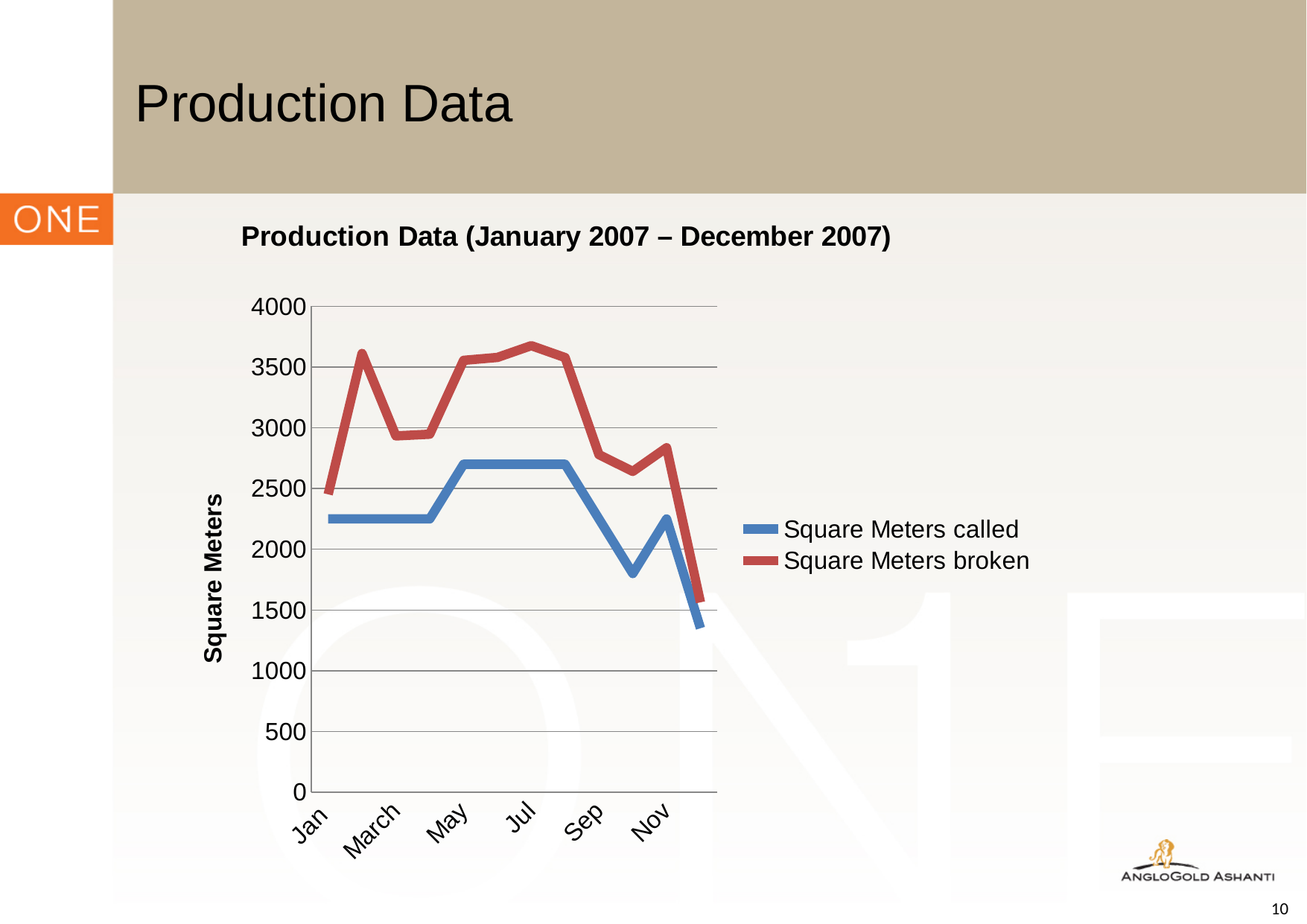
Is the value for Square Meters broken in Jul greater or less than 3500? greater In which month is Square Meters called at its lowest? Dec Is the value for Square Meters broken in March greater or less than 3500? less Is the value for Square Meters called in Jul greater or less than 2500? greater What is the label of the vertical axis? Square Meters How many month labels are shown on the x axis? 6 How many series does the legend list? 2 Do the values for Square Meters broken rise or fall from Nov to the last point? fall In Jul, which series has the larger value, Square Meters called or Square Meters broken? Square Meters broken What is the title of the chart? Production Data (January 2007 – December 2007) What kind of chart is shown on the slide? line chart